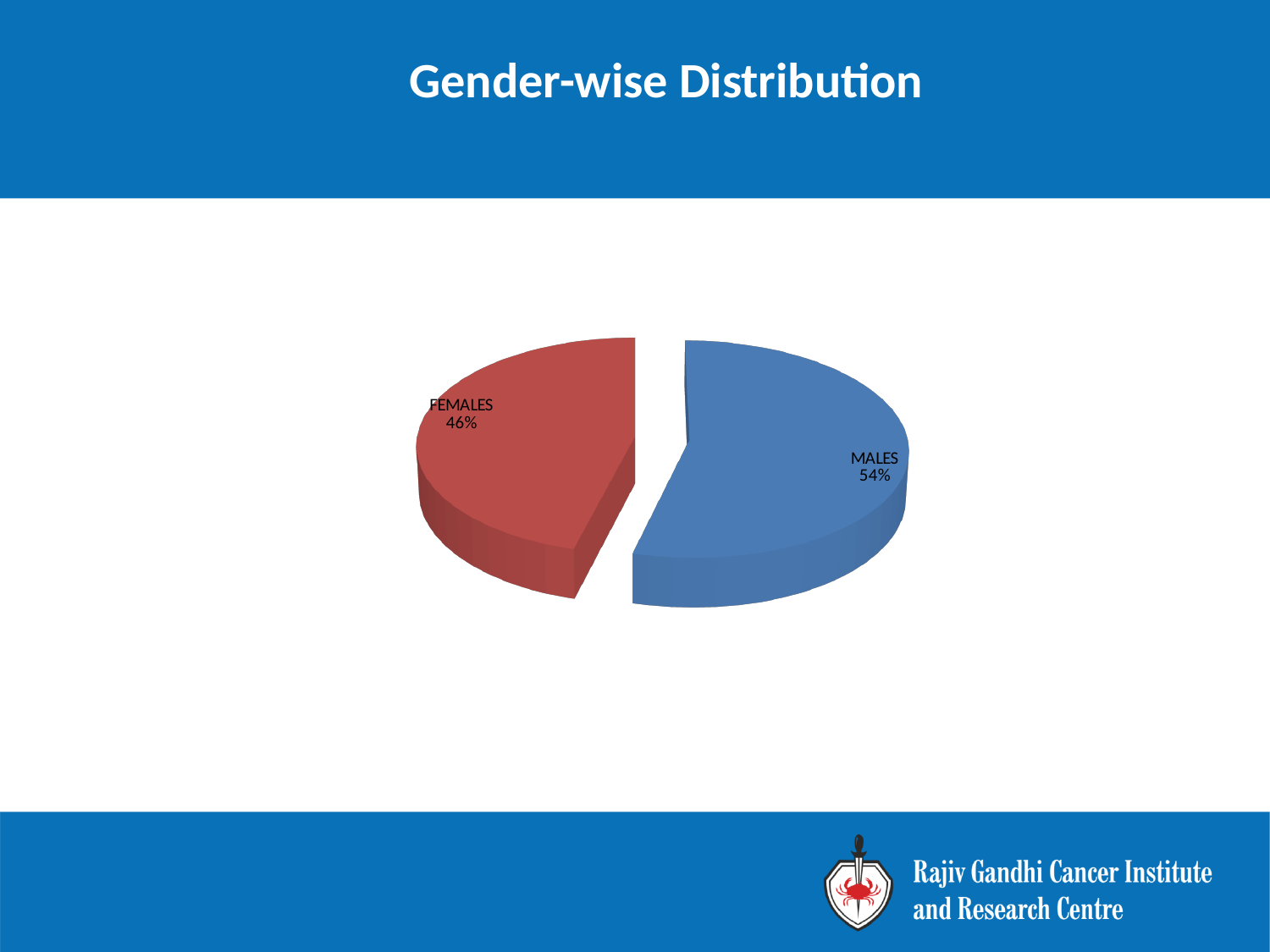
What is the difference in percentage points between the MALES and FEMALES slices? 8 How many slices does the pie chart have? 2 What share of the pie is FEMALES? 46% Which category has the smallest slice of the pie? FEMALES What share of the pie is MALES? 54% What colour is the MALES slice? Blue Which slice is larger, MALES or FEMALES? MALES Is the share for MALES greater or less than 50%? greater Which category has the largest slice of the pie? MALES Is the share for FEMALES greater or less than 50%? less What kind of chart is shown on the slide? Pie chart What is the title of the slide? Gender-wise Distribution